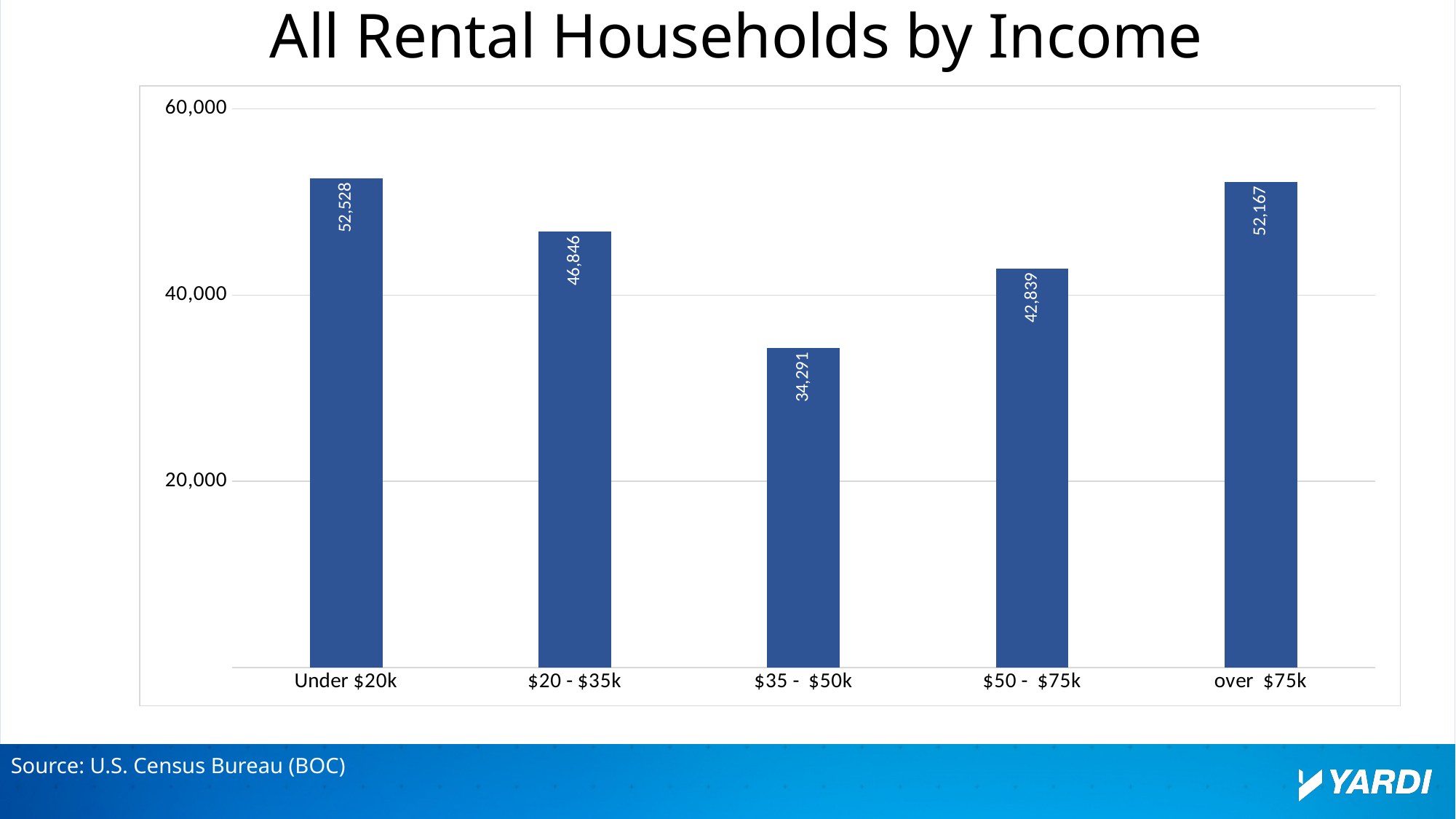
What is the value for over $75k? 52,167 What is the difference between the values for $20 - $35k and $35 - $50k? 12,555 Is the value for $35 - $50k greater or less than 40,000? less Which income category has the highest value? Under $20k What is the value for $35 - $50k? 34,291 Which is larger, the value for $20 - $35k or the value for $50 - $75k? $20 - $35k What is the value for Under $20k? 52,528 What is the difference between the values for Under $20k and over $75k? 361 What kind of chart is shown on the slide? bar chart What is the value for $50 - $75k? 42,839 How many income categories are shown on the chart? 5 Which income category has the lowest value? $35 - $50k